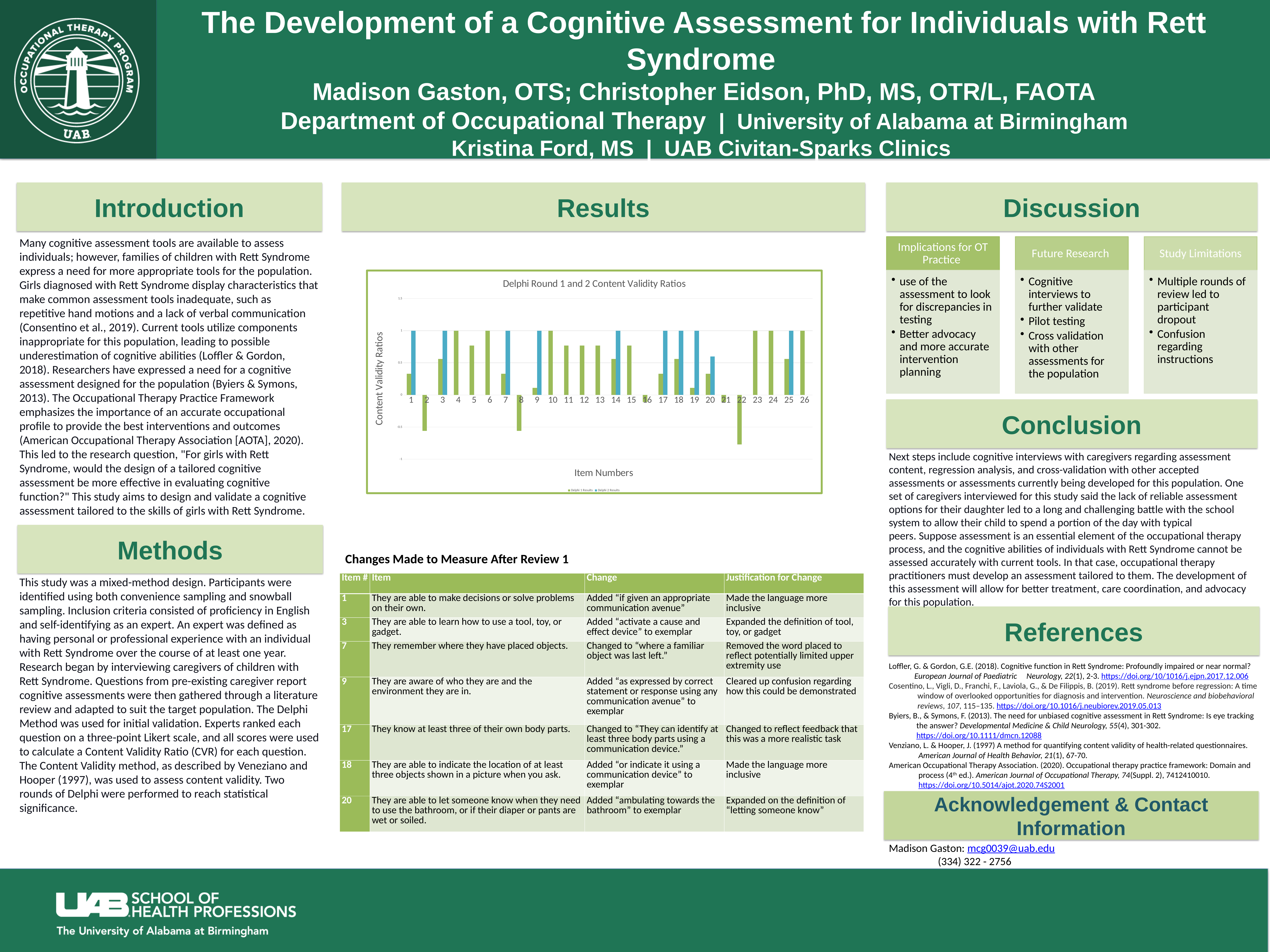
How many series does the chart's legend list? 2 Is the Delphi 1 Results value for item 5 greater or less than 0.5? greater Which item number has the lowest Delphi 1 Results value? 22 Is the Delphi 1 Results value for item 9 greater or less than 0.5? less What is the title of the chart in the Results section? Delphi Round 1 and 2 Content Validity Ratios How many item numbers are shown along the x axis of the chart? 26 What is the label of the x axis of the chart? Item Numbers For item 1, which is larger: the Delphi 1 Results value or the Delphi 2 Results value? Delphi 2 Results What kind of chart is shown in the Results section? bar chart Is the Delphi 1 Results value for item 2 greater or less than 0? less What is the Delphi 1 Results value for item 4? 1